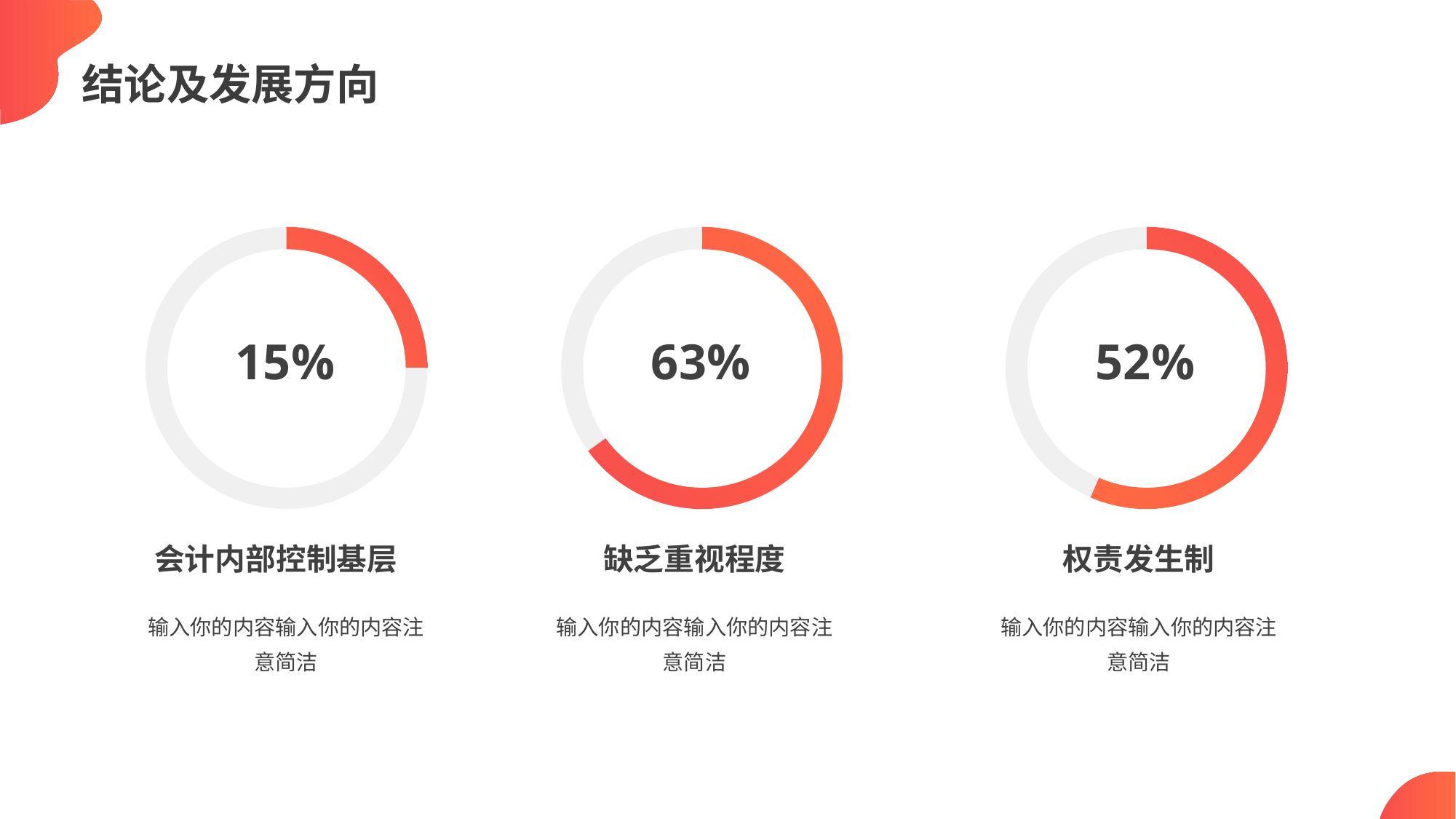
Which is larger, the percentage for 权责发生制 or the percentage for 会计内部控制基层? 权责发生制 What percentage is shown in the donut chart labelled 缺乏重视程度? 63% What is the difference between the percentages shown for 权责发生制 and 会计内部控制基层? 37% What is the title of the slide containing the three donut charts? 结论及发展方向 Which is larger, the percentage for 缺乏重视程度 or the percentage for 会计内部控制基层? 缺乏重视程度 Which of the three donut charts shows the lowest percentage? 会计内部控制基层 What kind of chart is used to display the percentages on this slide? Donut chart What percentage is shown in the donut chart labelled 权责发生制? 52% How many donut charts are shown on the slide? 3 What is the difference between the percentages shown for 缺乏重视程度 and 权责发生制? 11% Which of the three donut charts shows the highest percentage? 缺乏重视程度 What percentage is shown in the donut chart labelled 会计内部控制基层? 15%